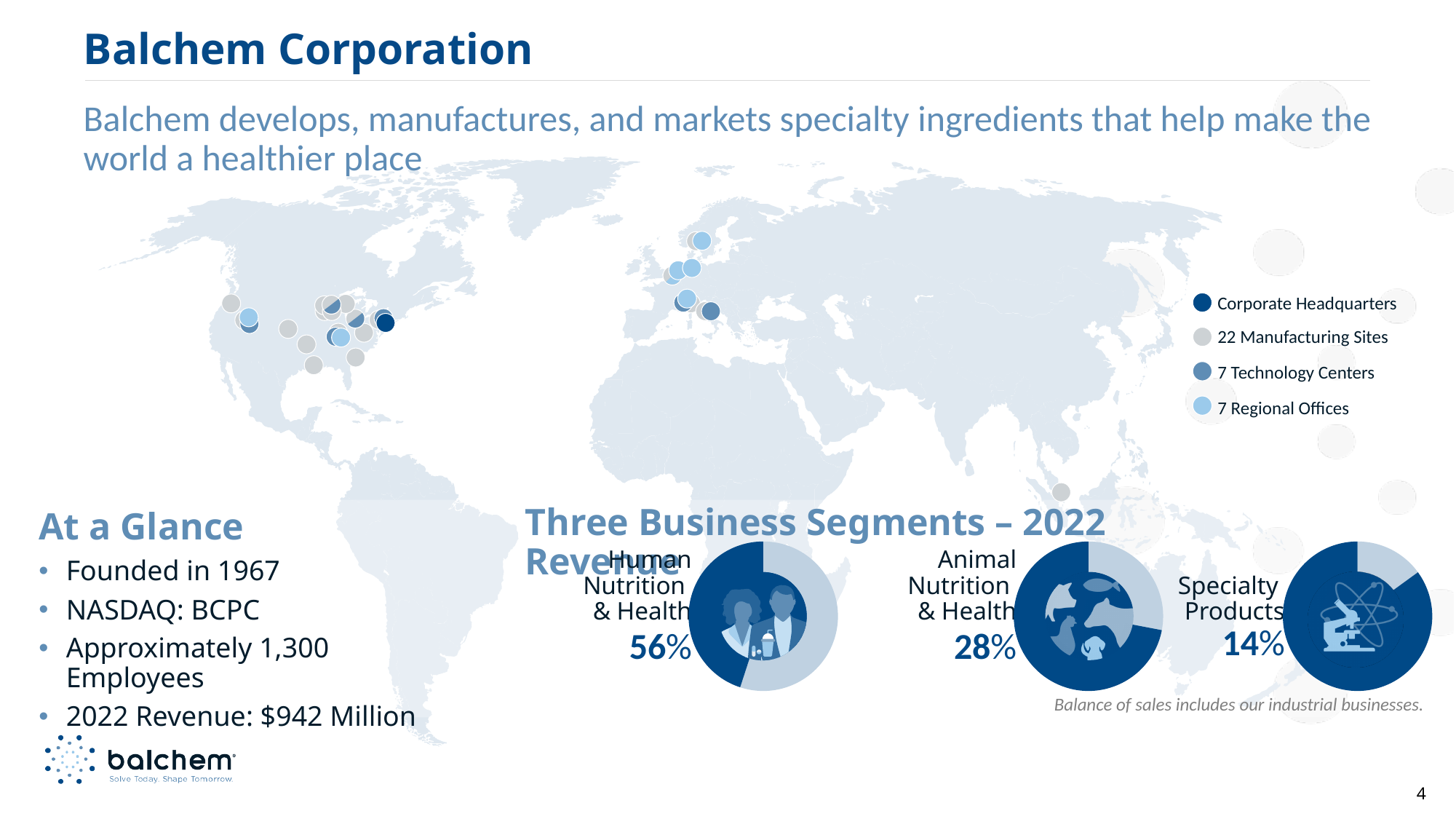
In the 'Three Business Segments – 2022 Revenue' charts, what share of revenue does Specialty Products represent? 14% Among the three business segments shown for 2022 revenue, which has the largest share? Human Nutrition & Health According to the map legend, how many manufacturing sites does Balchem have? 22 What do the three 2022 revenue segment shares add up to in total? 98% In the 2022 revenue segment charts, what is the difference in percentage points between Animal Nutrition & Health and Specialty Products? 14 In the 2022 revenue segment charts, how many percentage points larger is Human Nutrition & Health than Animal Nutrition & Health? 28 Among the three business segments shown for 2022 revenue, which has the smallest share? Specialty Products How many business segments are shown in the 'Three Business Segments – 2022 Revenue' charts? 3 In the 'Three Business Segments – 2022 Revenue' charts, what share of revenue does Human Nutrition & Health represent? 56% In the 'Three Business Segments – 2022 Revenue' charts, what share of revenue does Animal Nutrition & Health represent? 28% In the 2022 revenue segment charts, which is larger: Animal Nutrition & Health or Specialty Products? Animal Nutrition & Health What kind of chart is used to show each business segment's share of 2022 revenue? Donut (pie) chart